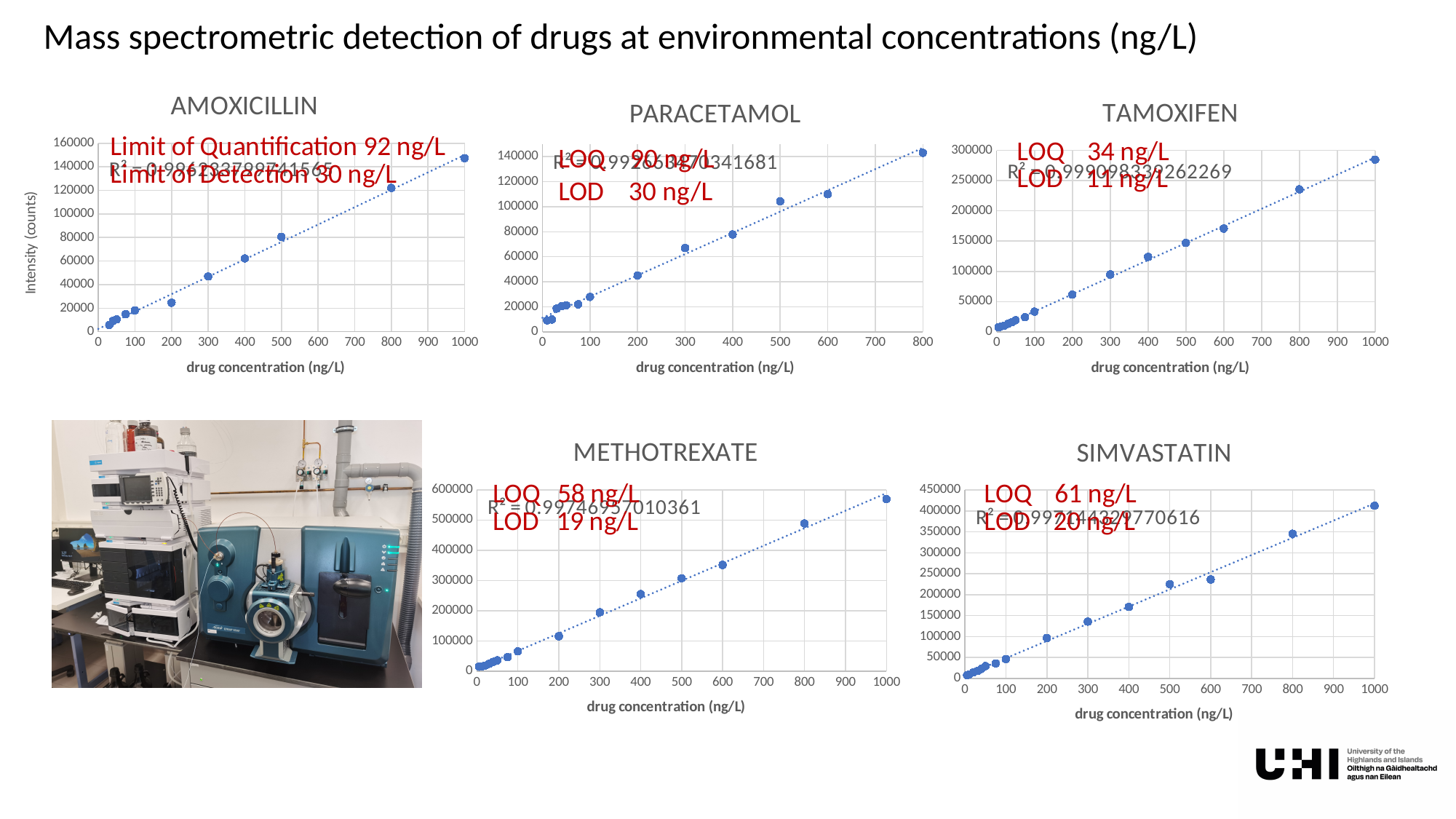
In the TAMOXIFEN chart, which has the lower intensity: 300 ng/L or 500 ng/L? 300 ng/L How many charts are shown on the slide? 5 In the PARACETAMOL chart, is the intensity at 600 ng/L greater or less than 100000? greater What kind of chart is the AMOXICILLIN chart? scatter chart In the PARACETAMOL chart, do the intensity values rise or fall as drug concentration increases? rise In the PARACETAMOL chart, at which drug concentration is the intensity highest? 800 In the TAMOXIFEN chart, is the intensity at 1000 ng/L greater or less than 250000? greater In the AMOXICILLIN chart, is the intensity at 800 ng/L greater or less than 100000? greater What is the y-axis label of the AMOXICILLIN chart? Intensity (counts) In the METHOTREXATE chart, which has the higher intensity: 600 ng/L or 800 ng/L? 800 ng/L